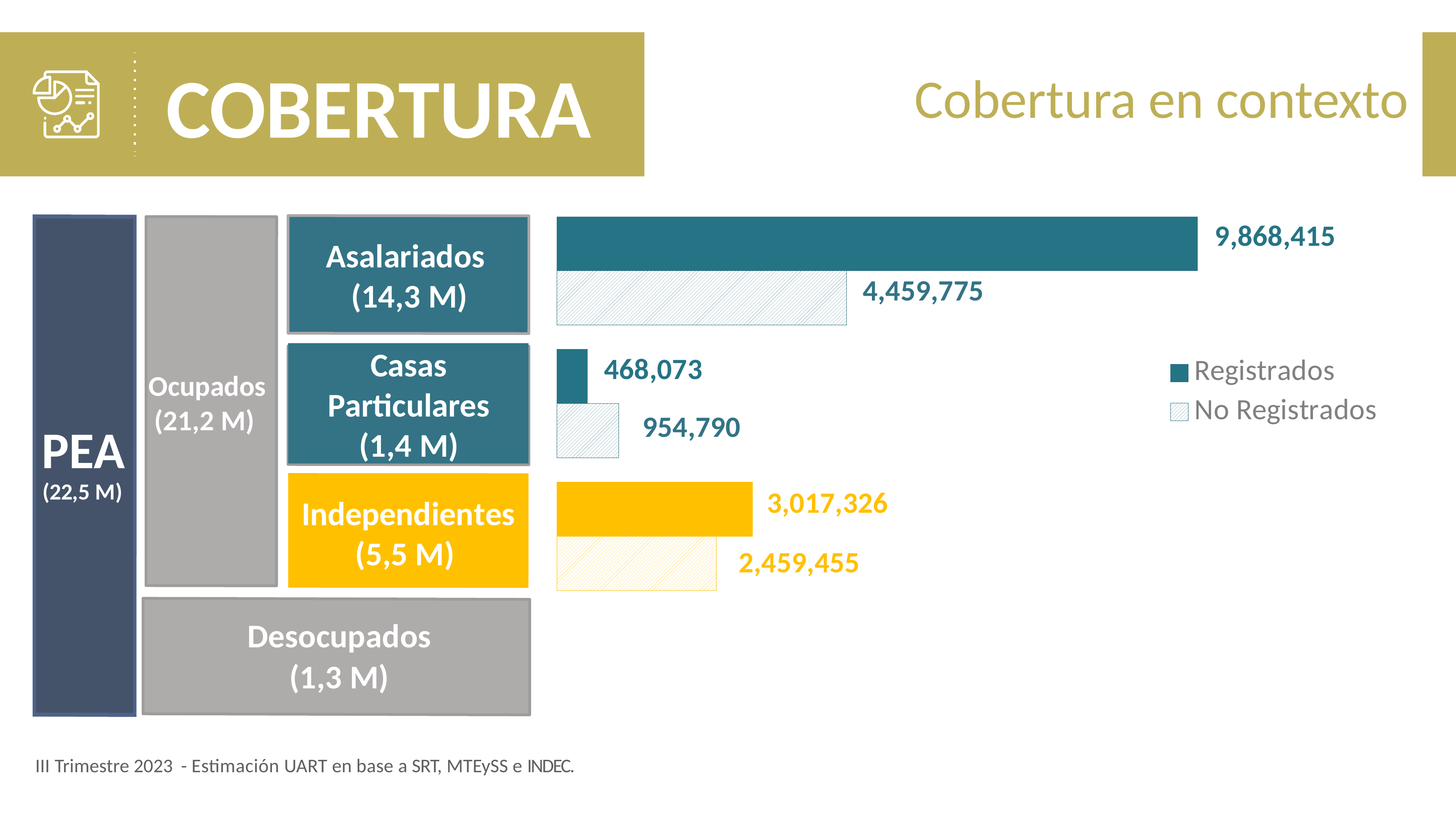
Which category has the highest Registrados value? Asalariados What kind of chart is shown on the slide? Bar chart What is the Registrados value for Independientes? 3,017,326 What is the difference between the Registrados and No Registrados values for Asalariados? 5,408,640 What is the No Registrados value for Independientes? 2,459,455 How many categories are plotted in the bar chart? 3 What is the difference between the No Registrados and Registrados values for Casas Particulares? 486,717 What is the Registrados value for Asalariados? 9,868,415 What is the No Registrados value for Casas Particulares? 954,790 How many series does the legend list? 2 Which category has the lowest Registrados value? Casas Particulares For Independientes, which is larger: Registrados or No Registrados? Registrados